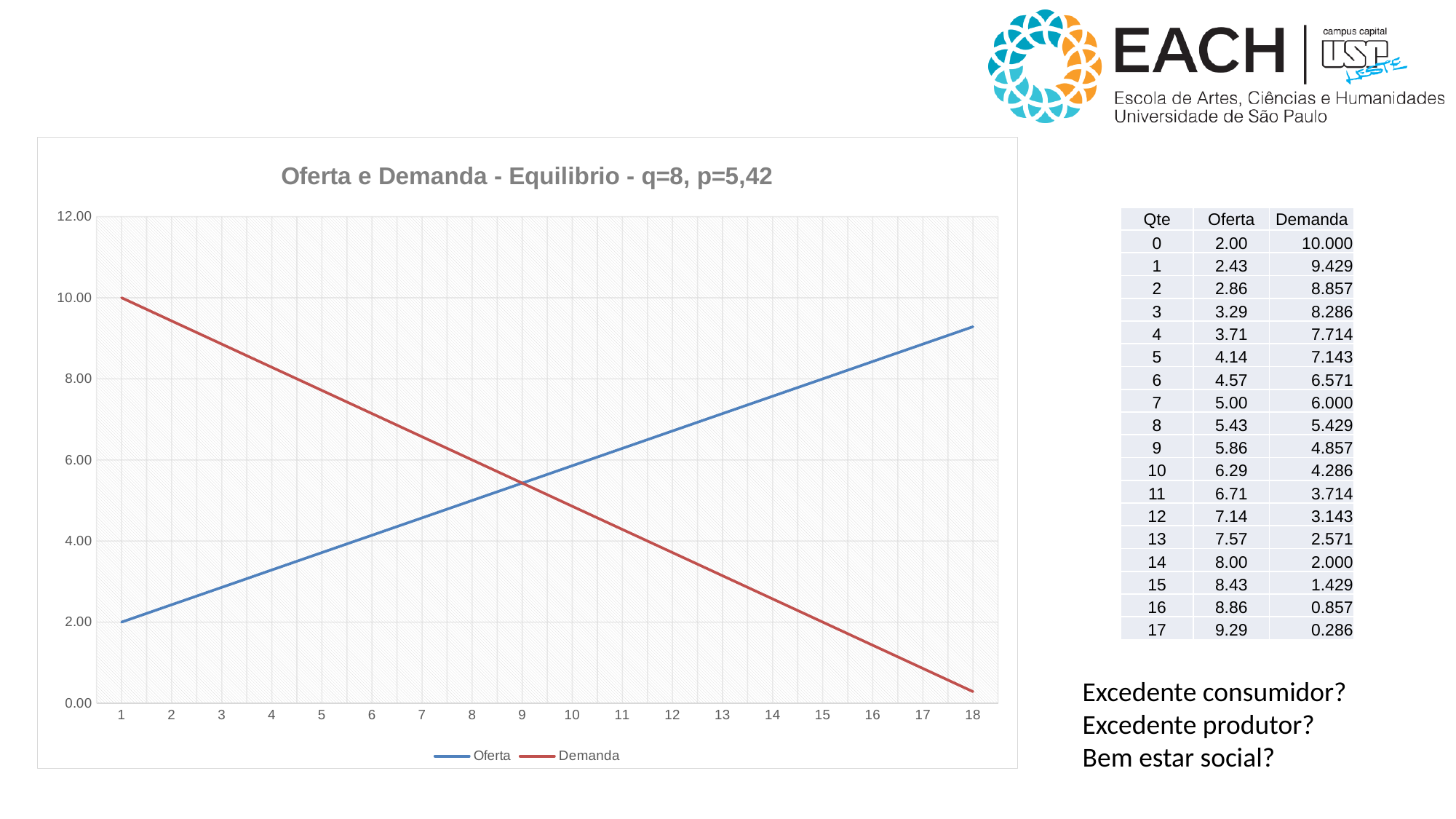
At x = 5, which line has the larger value, Oferta or Demanda? Demanda What is the title of the chart? Oferta e Demanda - Equilibrio - q=8, p=5,42 How many points are marked along the x axis of the chart? 18 What is the value of the Demanda line at x = 1? 10.00 How many series does the chart legend list? 2 Is the value of the Oferta line at x = 18 greater or less than 8.00? greater Does the Demanda line rise or fall as x increases? fall What is the value of the Oferta line at x = 1? 2.00 Which colour is used for the Demanda line? red What kind of chart is shown on the slide? line chart Is the value of the Demanda line at x = 12 greater or less than 4.00? less Does the Oferta line rise or fall as x increases? rise